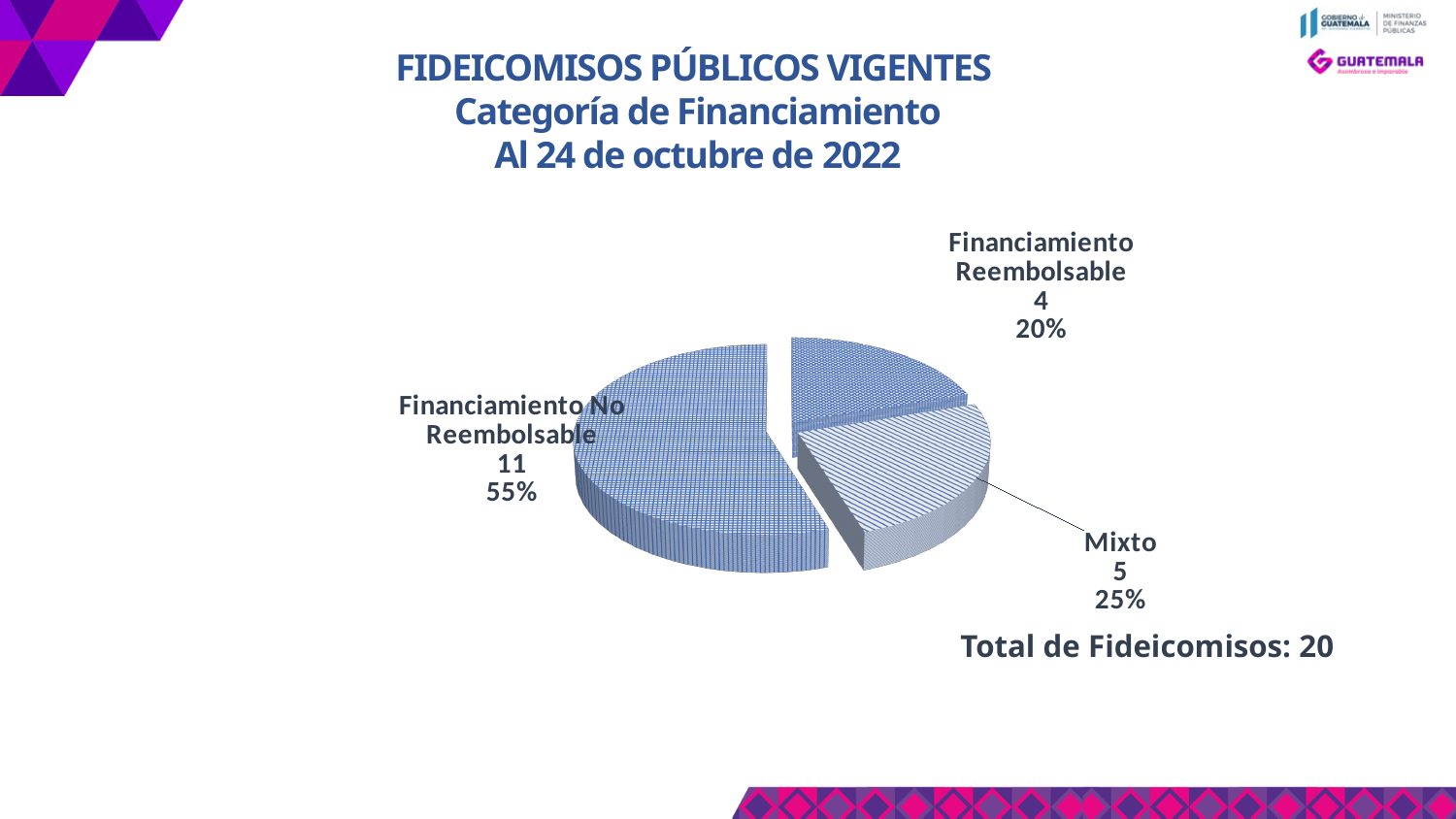
What is the difference in the number of fideicomisos between Financiamiento No Reembolsable and Mixto? 6 What share of the pie does Financiamiento Reembolsable represent? 20% How many fideicomisos are in the Financiamiento Reembolsable category? 4 Which category has the smallest number of fideicomisos? Financiamiento Reembolsable What share of the pie does Mixto represent? 25% Which category has more fideicomisos, Mixto or Financiamiento Reembolsable? Mixto How many categories does the pie chart show? 3 How many fideicomisos are in the Financiamiento No Reembolsable category? 11 How many fideicomisos are in the Mixto category? 5 What share of the pie does Financiamiento No Reembolsable represent? 55% What kind of chart is shown on the slide? Pie chart Which category has the largest number of fideicomisos? Financiamiento No Reembolsable